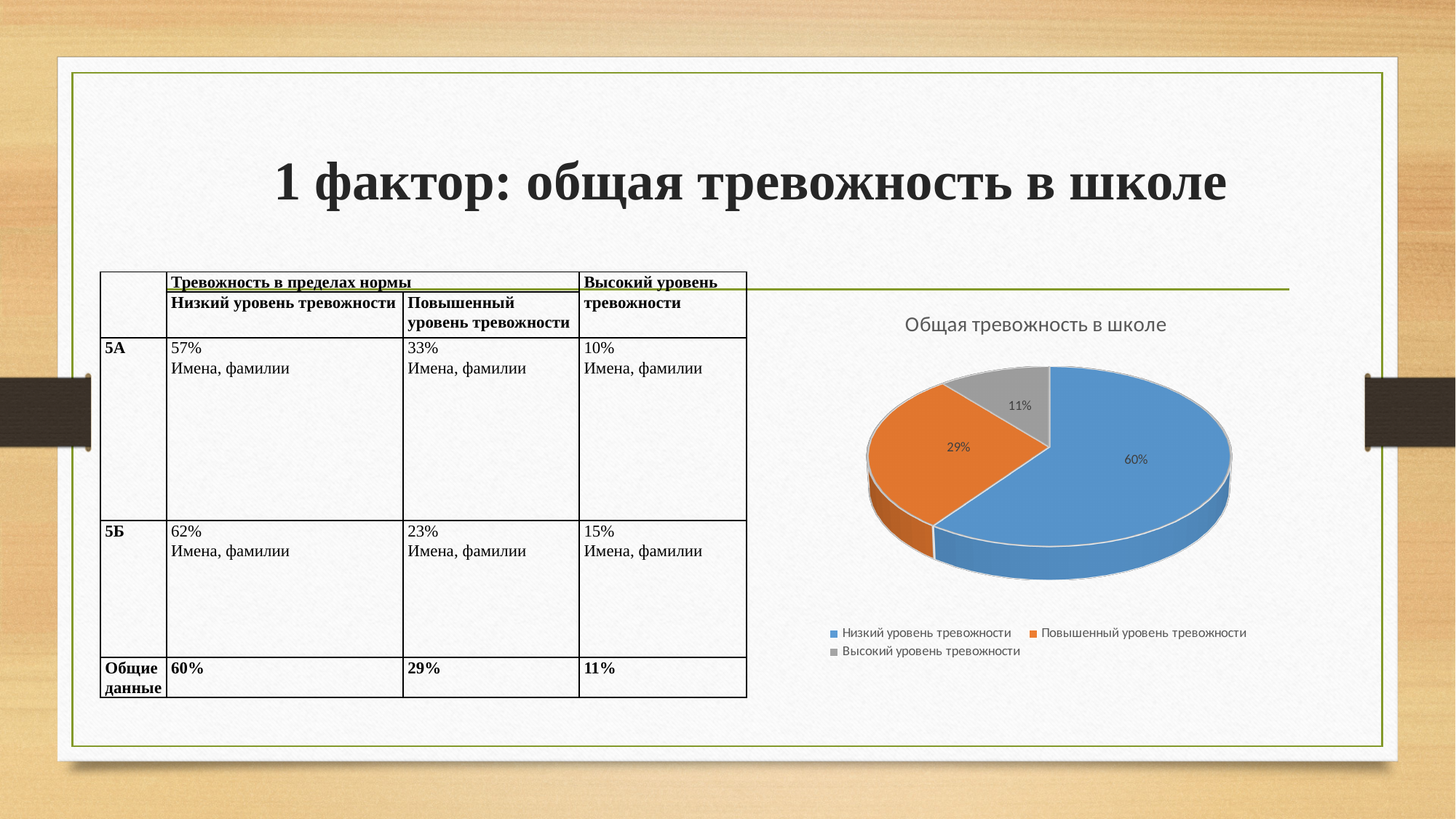
What type of chart is shown on the slide? Pie chart How many entries does the legend of the pie chart list? 3 Which category has the smallest slice in the pie chart? Высокий уровень тревожности What is the difference between the 'Низкий уровень тревожности' slice and the 'Повышенный уровень тревожности' slice in the pie chart? 31% What share of the pie chart is labelled 'Повышенный уровень тревожности'? 29% Which slice is larger in the pie chart: 'Повышенный уровень тревожности' or 'Высокий уровень тревожности'? Повышенный уровень тревожности What share of the pie chart is labelled 'Низкий уровень тревожности'? 60% What colour is the 'Высокий уровень тревожности' slice in the pie chart? Grey What share of the pie chart is labelled 'Высокий уровень тревожности'? 11% What is the title of the pie chart? Общая тревожность в школе How many slices does the pie chart have? 3 Which category has the largest slice in the pie chart? Низкий уровень тревожности